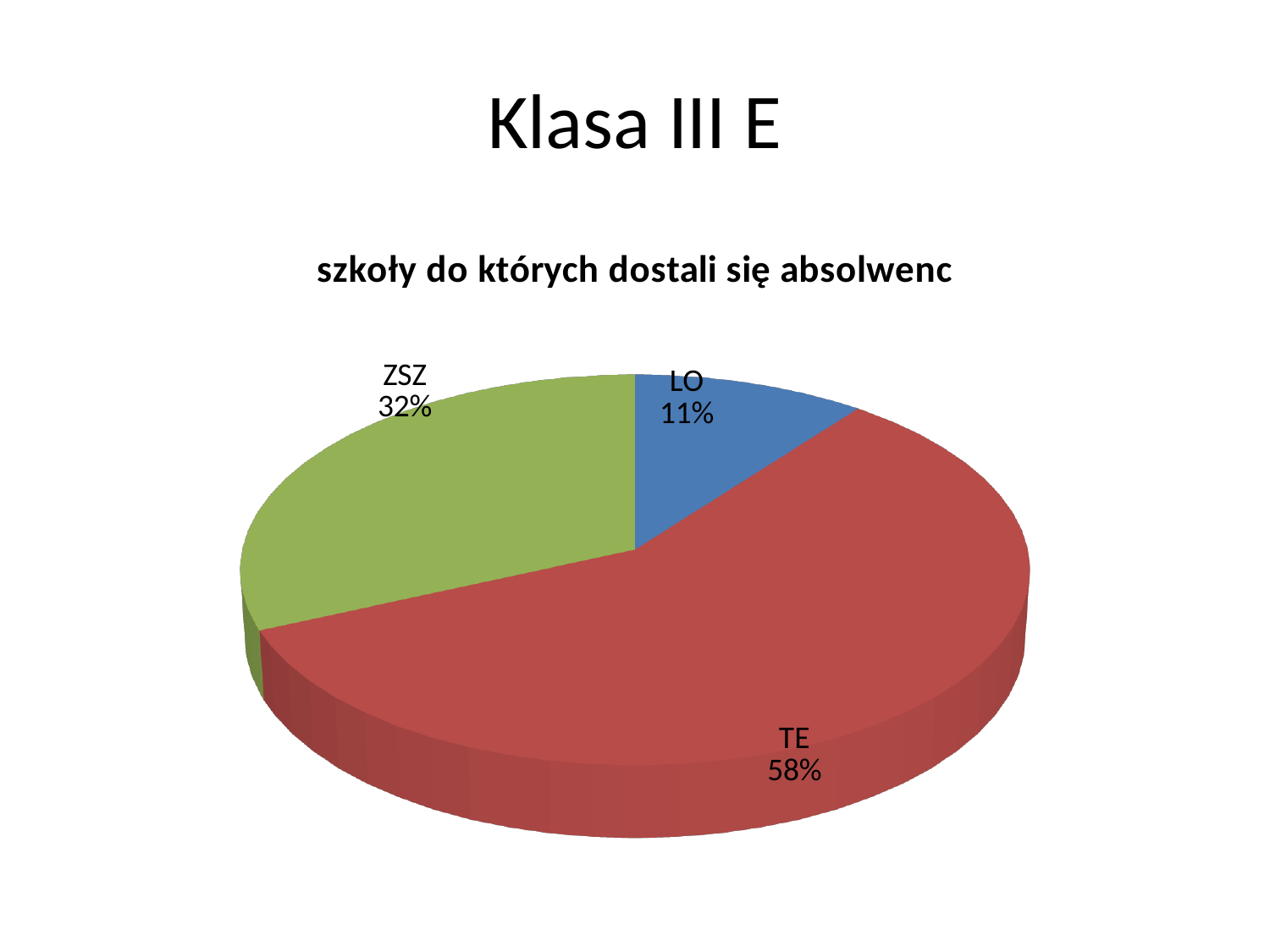
What is the title of the chart? szkoły do których dostali się absolwenc What kind of chart is shown on the slide? Pie chart What is the difference in percentage points between the TE and ZSZ slices? 26 What share of the pie does TE have? 58% How many slices does the pie chart have? 3 Which category has the largest slice of the pie? TE What colour is the TE slice? Red What share of the pie does ZSZ have? 32% Which category has the smallest slice of the pie? LO What is the difference in percentage points between the ZSZ and LO slices? 21 Which is larger, the ZSZ slice or the LO slice? ZSZ What share of the pie does LO have? 11%